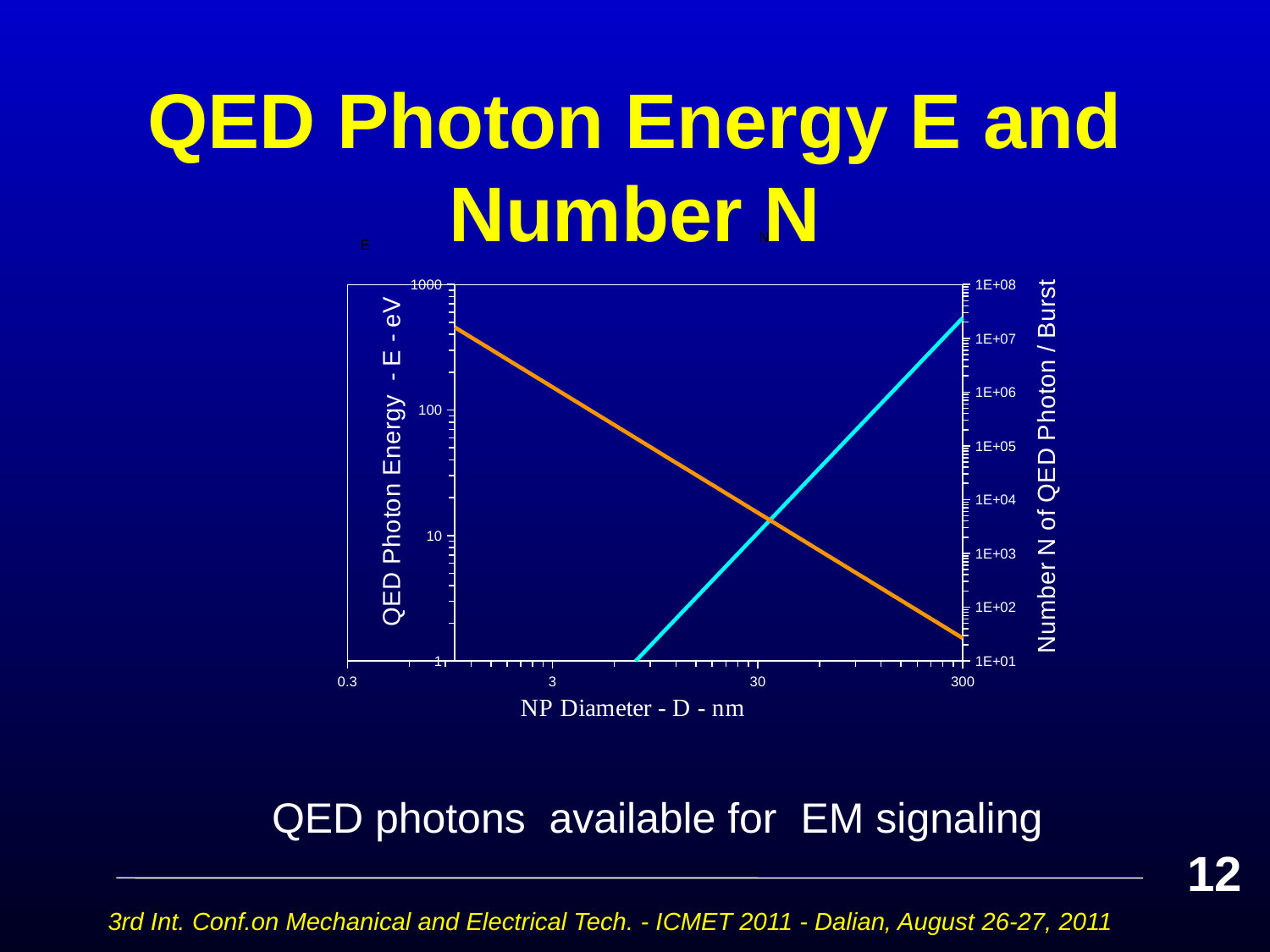
Is the QED Photon Energy E at a diameter of 3 nm greater or less than 100 eV? greater How many lines (series) are plotted on the chart? 2 Is the QED Photon Energy E at a diameter of 30 nm greater or less than 10 eV? greater Is the Number N of QED photons per burst at a diameter of 300 nm greater or less than 1E+06? greater What is the title of the left y axis of the chart? QED Photon Energy - E - eV Does the QED Photon Energy E (orange line) rise or fall as the NP diameter D increases? fall Does the Number N of QED photons per burst (cyan line) rise or fall as the NP diameter D increases? rise What is the highest tick value shown on the right y axis (Number N of QED Photon / Burst)? 1E+08 What is the title of the x axis of the chart? NP Diameter - D - nm What kind of chart is shown on the slide? line chart